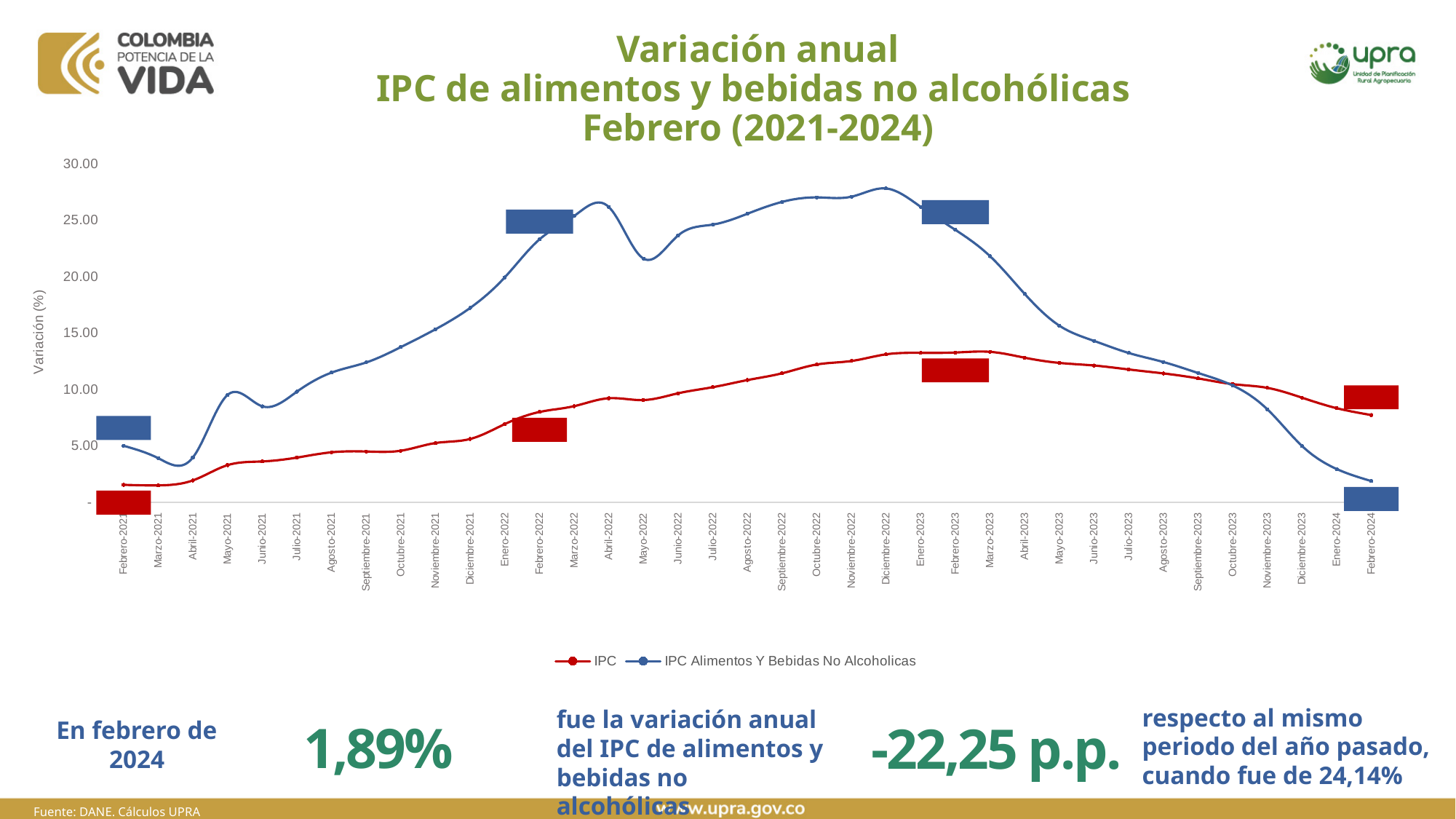
How many months are plotted along the x axis? 37 What kind of chart is shown on the slide? line chart How many series does the legend list? 2 According to the slide, what was the annual variation of IPC Alimentos Y Bebidas No Alcoholicas in Febrero-2023? 24,14% Is the value of IPC Alimentos Y Bebidas No Alcoholicas in Diciembre-2022 greater or less than 25.00? greater Does the IPC Alimentos Y Bebidas No Alcoholicas series rise or fall from Diciembre-2022 to Febrero-2024? fall Is the value of IPC in Febrero-2021 greater or less than 5.00? less In which month does the IPC Alimentos Y Bebidas No Alcoholicas series reach its lowest value? Febrero-2024 In Febrero-2024, which series has the higher value, IPC or IPC Alimentos Y Bebidas No Alcoholicas? IPC In which month does the IPC Alimentos Y Bebidas No Alcoholicas series reach its highest value? Diciembre-2022 By how many percentage points did the IPC Alimentos Y Bebidas No Alcoholicas variation change from Febrero-2023 to Febrero-2024? -22,25 p.p. According to the slide, what was the annual variation of IPC Alimentos Y Bebidas No Alcoholicas in Febrero-2024? 1,89%